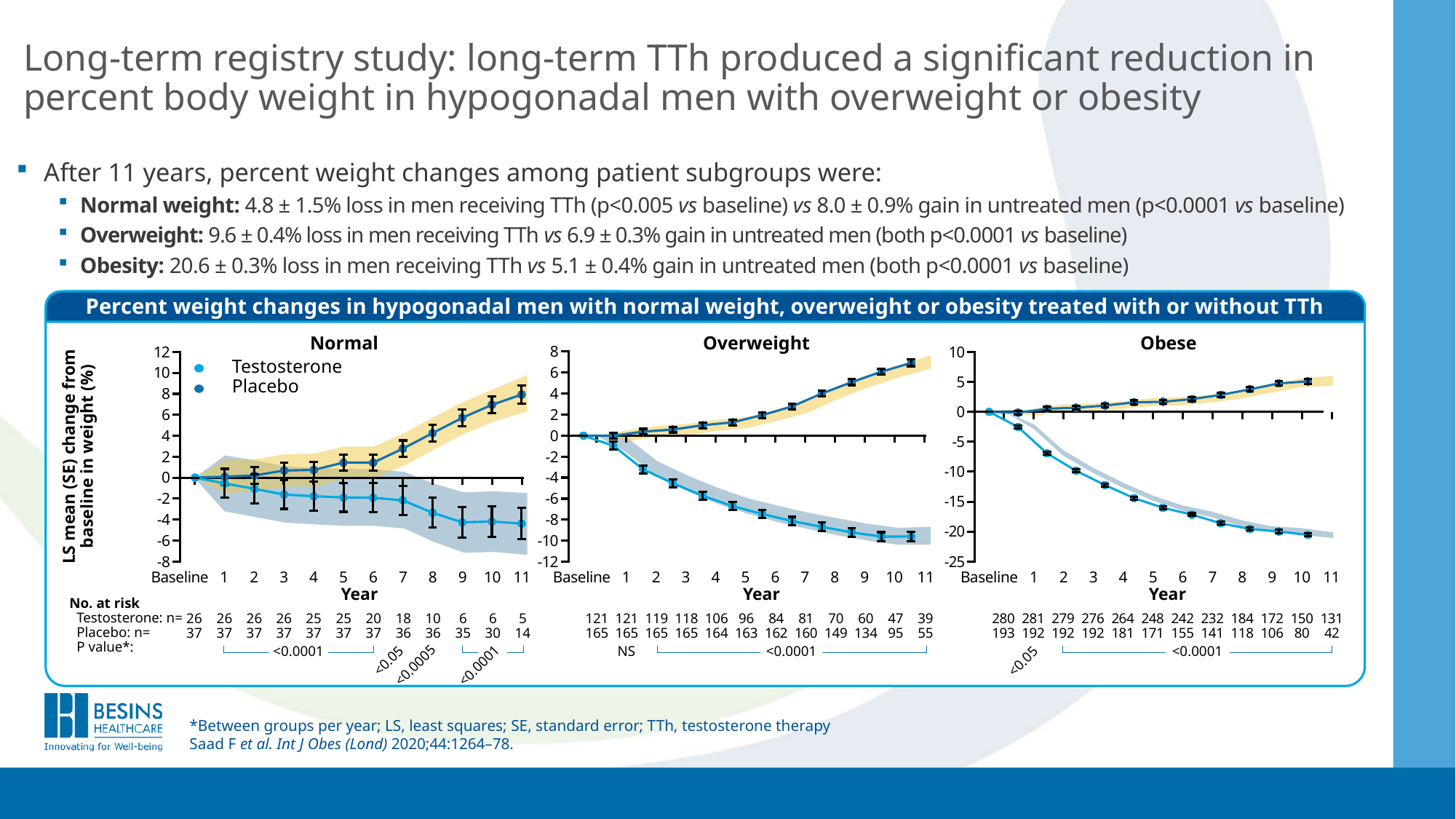
In the Overweight chart, is the Placebo value at year 11 greater or less than 4? greater What kind of chart is the Normal panel? Line chart What are the two series named in the legend of the Normal panel? Testosterone and Placebo In the Obese chart, does the Testosterone line rise or fall from baseline to year 11? Falls In the Obese chart, which line is higher at year 11, Testosterone or Placebo? Placebo How many series does the legend in the Normal panel list? 2 In the Normal chart, is the Placebo value at year 11 greater or less than 4? greater How many time points, including baseline, are shown on the x axis of the Normal chart? 12 In the Overweight chart, what is the number at risk in the Placebo group at baseline? 165 In the Overweight chart, does the Placebo line rise or fall from baseline to year 11? Rises In the Obese chart, what is the number at risk in the Testosterone group at year 11? 131 In the Obese chart, is the Testosterone value at year 11 greater or less than -15? less